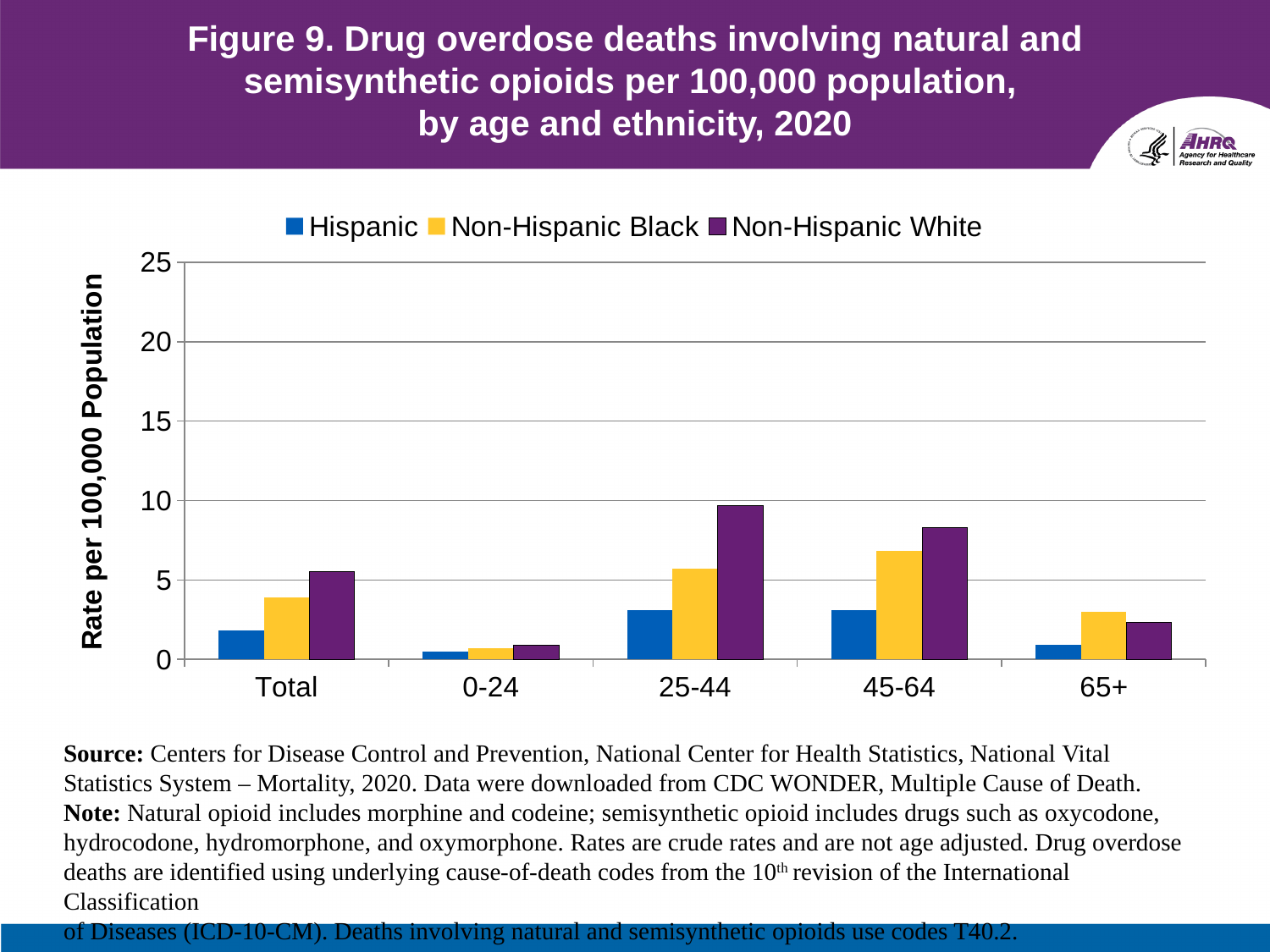
In the Total category, which ethnicity has the highest rate? Non-Hispanic White What kind of chart is shown on the slide? Bar chart How many series does the legend list? 3 In the 65+ category, which is larger: the Non-Hispanic Black value or the Non-Hispanic White value? Non-Hispanic Black What is the title of the y axis? Rate per 100,000 Population In the 45-64 category, which is larger: the Hispanic value or the Non-Hispanic White value? Non-Hispanic White Is the value for Hispanic in the Total category greater or less than 5? less How many age categories are shown on the x axis? 5 Which age category has the highest value for Non-Hispanic White? 25-44 Is the value for Non-Hispanic White in the 25-44 category greater or less than 5? greater Is the value for Non-Hispanic Black in the 45-64 category greater or less than 5? greater Which age category has the lowest value for Non-Hispanic Black? 0-24